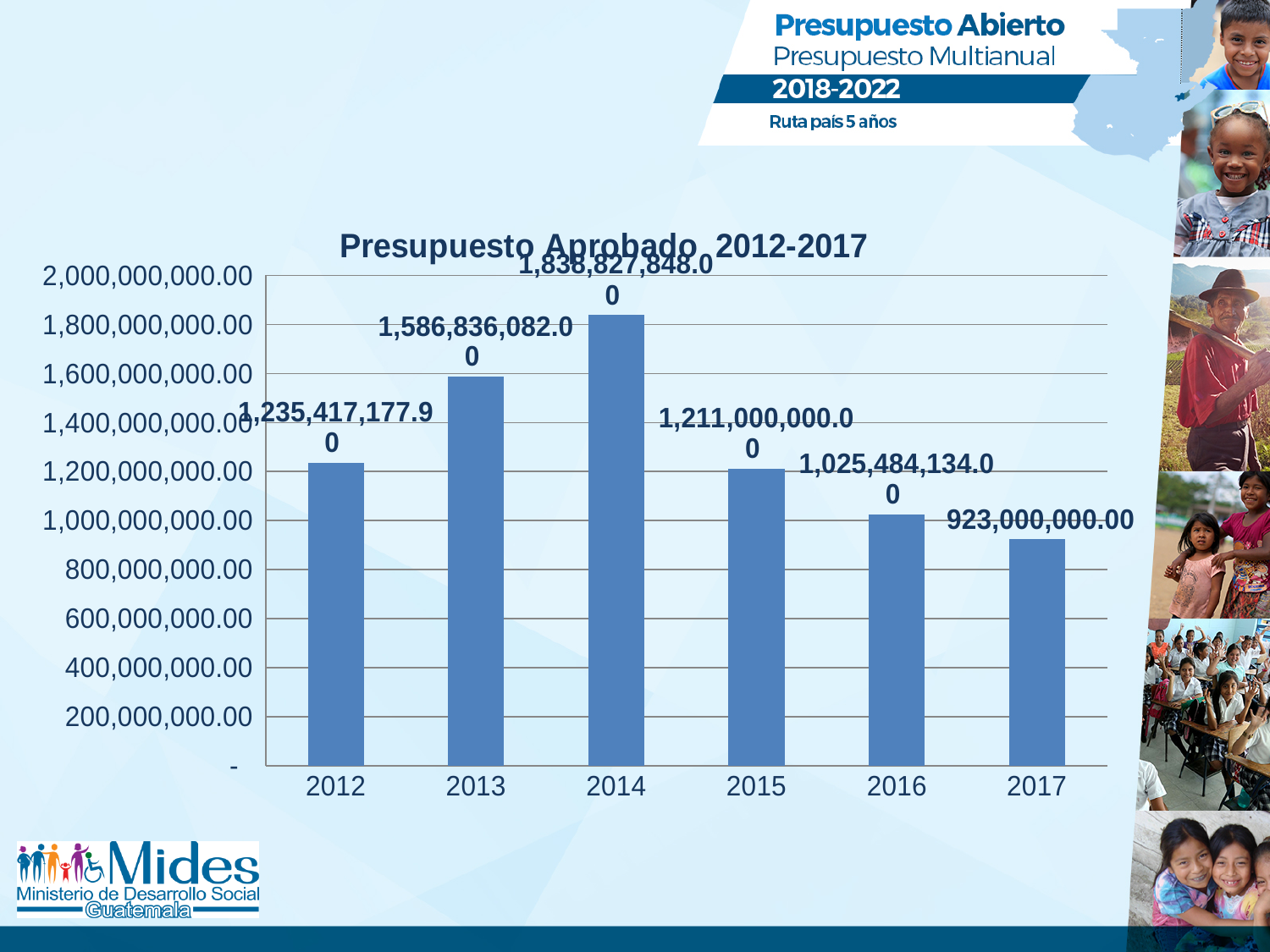
What is the approved budget value shown for 2016? 1,025,484,134.00 What is the approved budget value shown for 2014? 1,838,827,848.00 What is the approved budget value shown for 2017? 923,000,000.00 Is the value for 2016 greater or less than 1,200,000,000.00? less Which year has the highest approved budget? 2014 What is the difference between the approved budget for 2015 and for 2017? 288,000,000.00 Which year has a larger approved budget, 2013 or 2015? 2013 How many years are shown on the x axis of the chart? 6 What is the difference between the approved budget for 2014 and for 2013? 251,991,766.00 Which year has the lowest approved budget? 2017 What type of chart is shown on the slide? Bar chart What is the approved budget value shown for 2012? 1,235,417,177.90